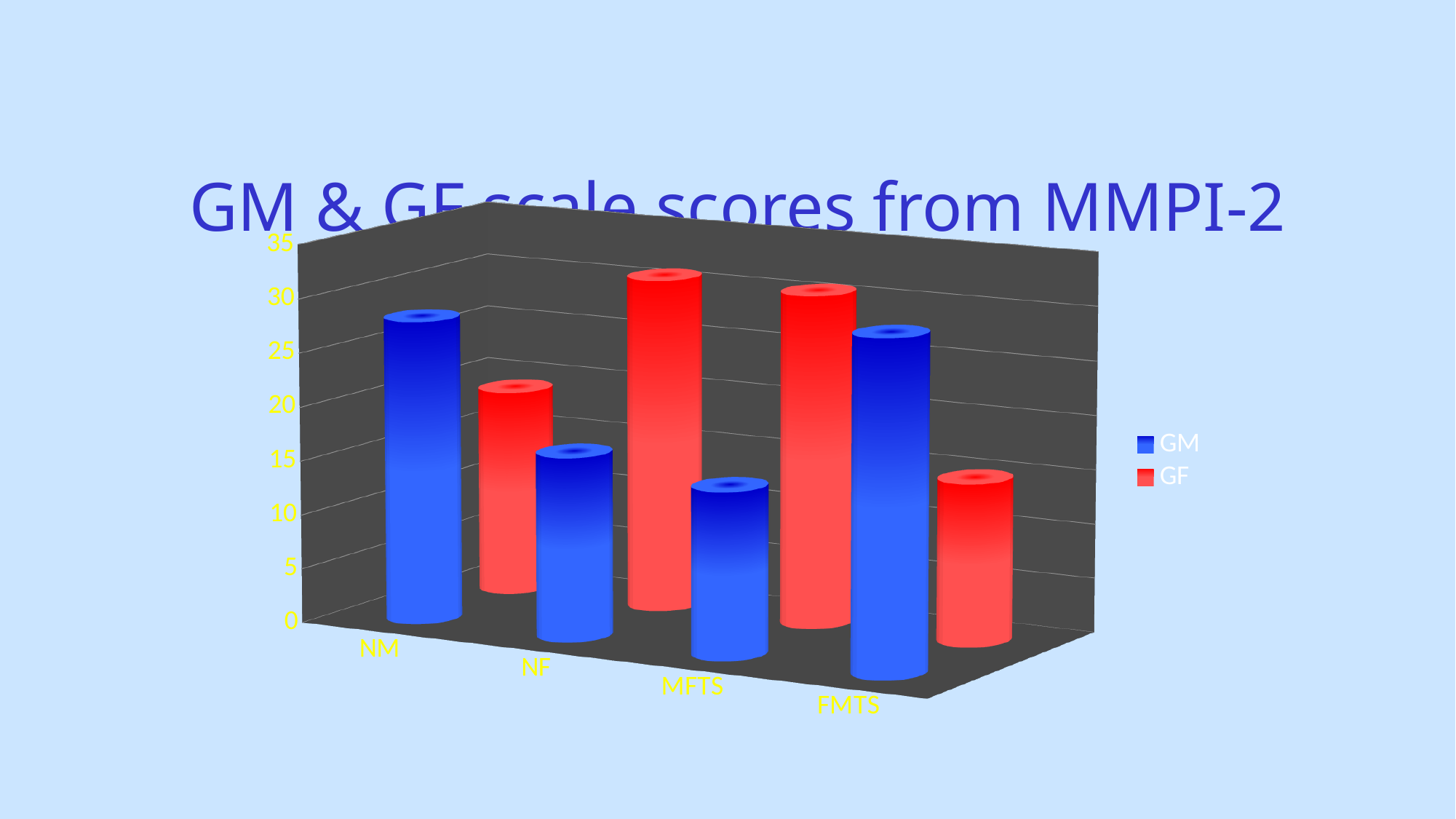
How many categories are shown on the x axis? 4 What is the title of the chart? GM & GF scale scores from MMPI-2 For NM, which series has the larger value, GM or GF? GM How many series does the legend list? 2 Is the GM value for MFTS greater or less than 20? less What kind of chart is shown on the slide? bar chart Which category has the highest GM value? FMTS Which category has the lowest GM value? MFTS Is the GM value for NM greater or less than 20? greater Which category has the lowest GF value? FMTS Which series is shown in red? GF For NF, which series has the larger value, GM or GF? GF